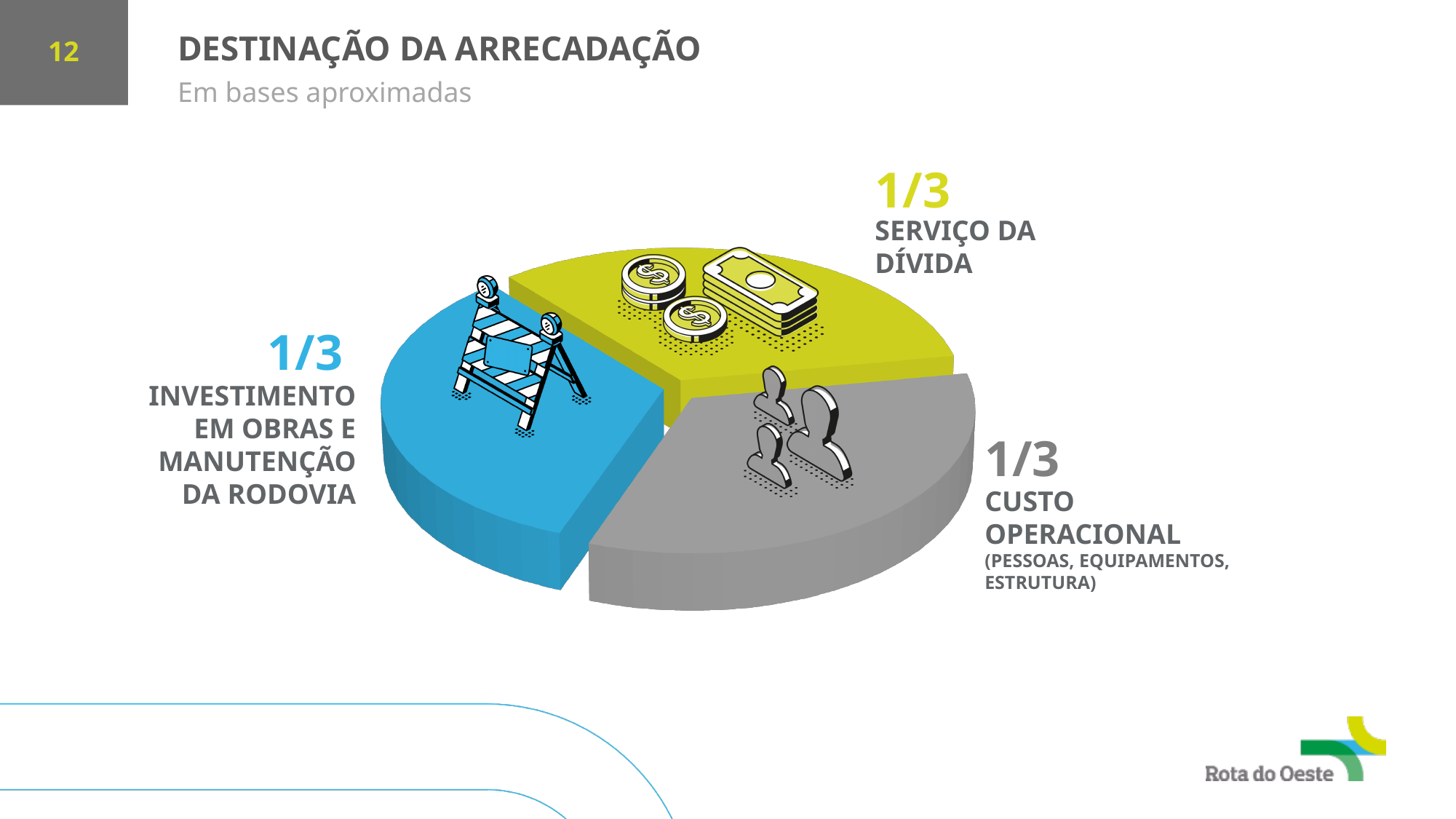
What share of the pie is labelled for Serviço da Dívida? 1/3 What share of the pie is labelled for Investimento em Obras e Manutenção da Rodovia? 1/3 Is the slice for Serviço da Dívida larger than, smaller than, or equal to the slice for Custo Operacional? Equal What is the title of the chart on the slide? Destinação da Arrecadação What share of the pie is labelled for Custo Operacional? 1/3 What kind of chart is shown on the slide? Pie chart Which slice is labelled with the sub-items Pessoas, Equipamentos, Estrutura? Custo Operacional How many slices does the pie chart have? 3 Is the slice for Investimento em Obras e Manutenção da Rodovia larger than, smaller than, or equal to the slice for Serviço da Dívida? Equal What colour is the slice for Investimento em Obras e Manutenção da Rodovia? Blue